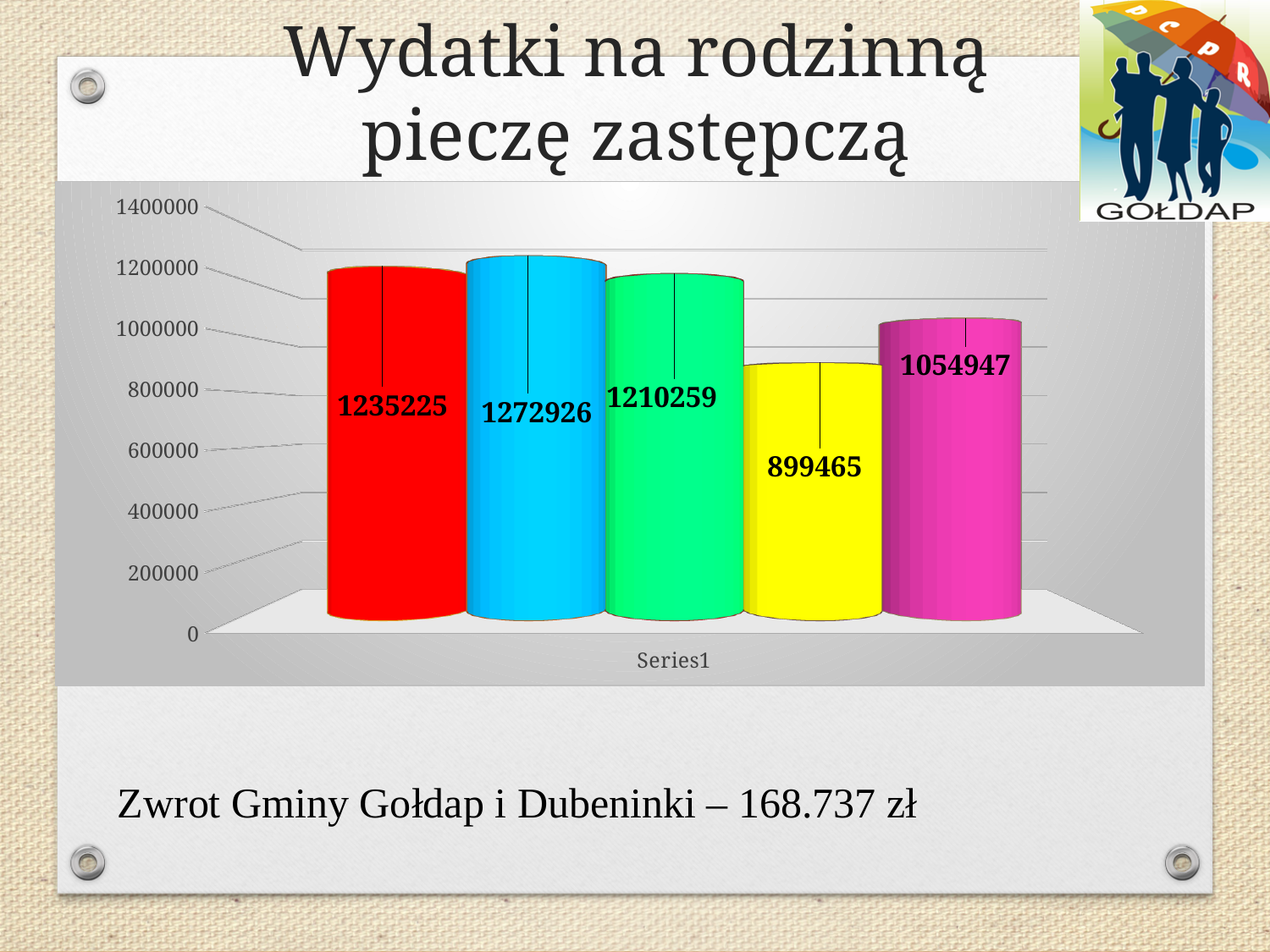
Which bar has the highest value? The blue bar (1272926) What is the difference between the highest value (blue bar) and the lowest value (yellow bar)? 373461 What is the difference between the red bar and the green bar? 24966 What value is shown on the magenta (pink) bar, the last one on the right? 1054947 What is the title of the chart on the slide? Wydatki na rodzinną pieczę zastępczą How many bars are plotted in the chart? 5 Which is larger, the value of the green bar or the value of the magenta bar? The green bar (1210259) What value is shown on the yellow bar? 899465 What value is shown on the red bar? 1235225 What value is shown on the blue bar? 1272926 What type of chart is shown on the slide? Bar chart Which bar has the lowest value? The yellow bar (899465)